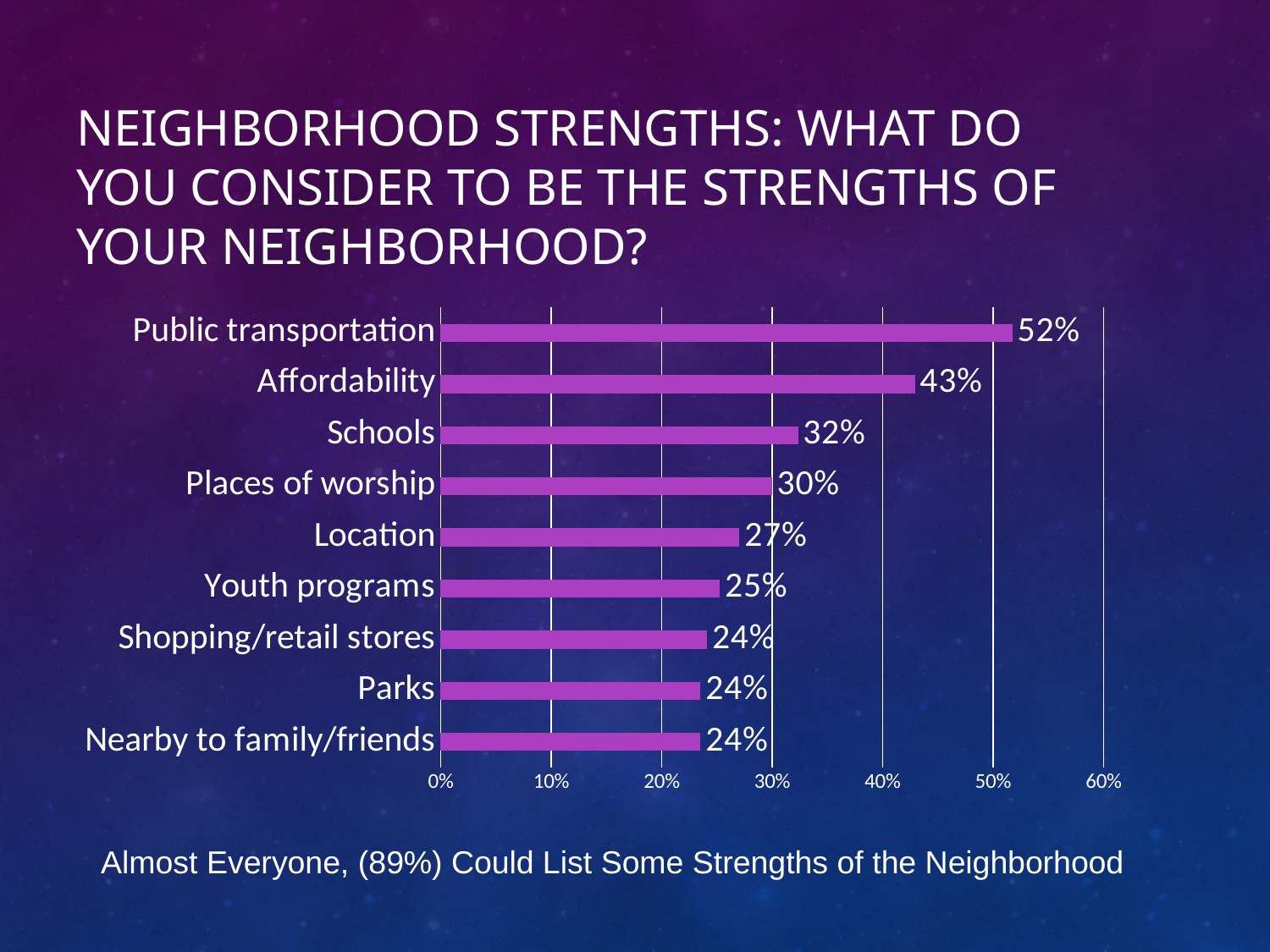
What is the difference between the values for Schools and Location? 5% What percentage of respondents listed Public transportation as a neighborhood strength? 52% What kind of chart is shown on the slide? Bar chart What is the value shown for Affordability? 43% Which category has the highest value in the chart? Public transportation Is the value for Affordability greater or less than 40%? greater What is the difference between the values for Public transportation and Affordability? 9% Which has a larger value, Schools or Youth programs? Schools How many categories are shown in the chart? 9 What is the value shown for Places of worship? 30% What is the highest value labeled on the horizontal axis? 60% How many categories share the value 24%? 3